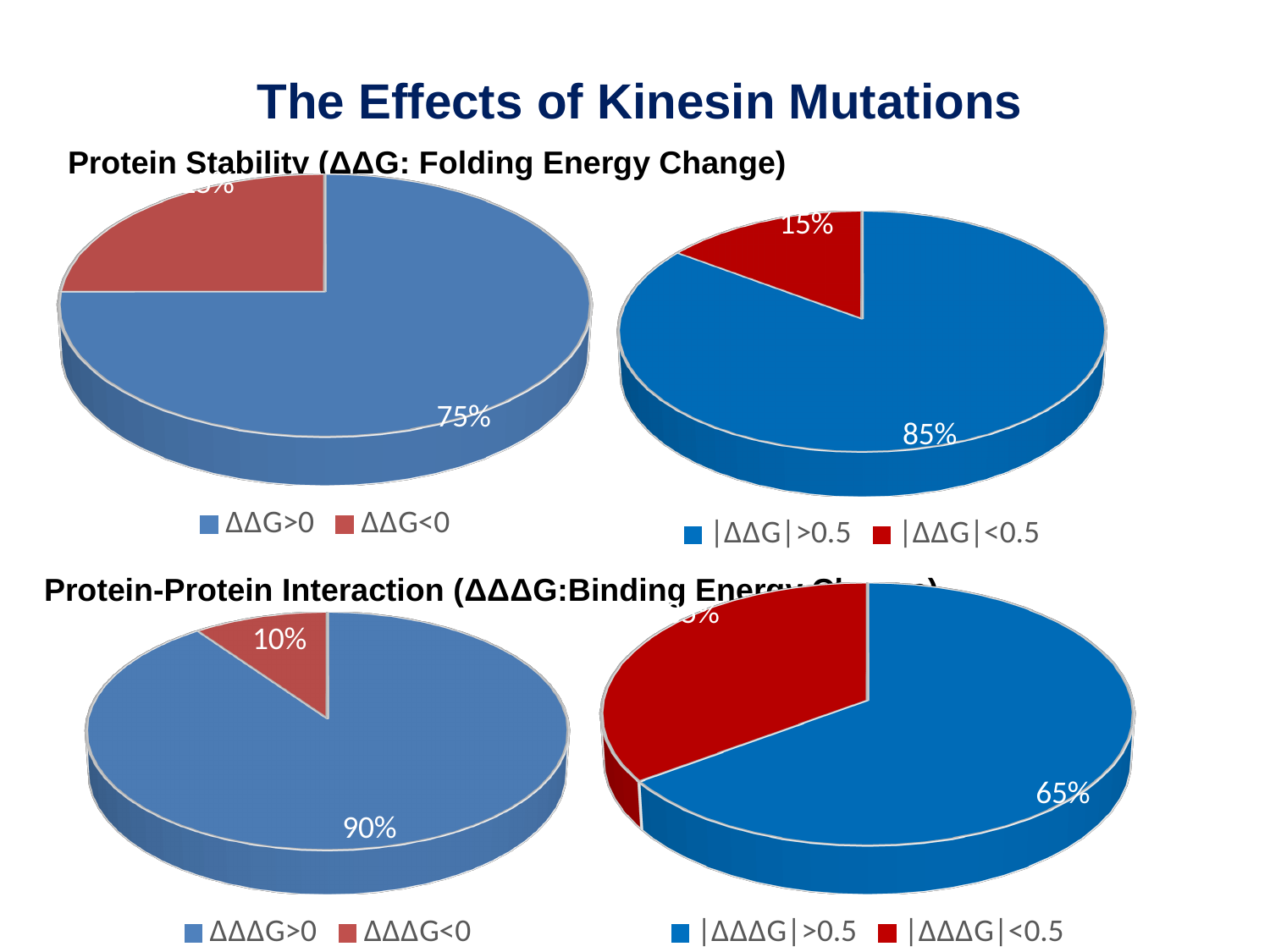
In the bottom-left pie chart, what percentage is shown for the ΔΔΔG>0 slice? 90% What type of chart is used in the bottom-right chart? Pie chart In the bottom-right pie chart, what percentage is shown for the |ΔΔΔG|>0.5 slice? 65% In the bottom-left pie chart, which slice is larger, ΔΔΔG>0 or ΔΔΔG<0? ΔΔΔG>0 How many entries does the legend of the top-right pie chart list? 2 In the top-right pie chart, what is the difference in percentage points between the |ΔΔG|>0.5 slice and the |ΔΔG|<0.5 slice? 70 In the top-right pie chart, what percentage is shown for the |ΔΔG|<0.5 slice? 15% In the top-right pie chart, what percentage is shown for the |ΔΔG|>0.5 slice? 85% In the top-left pie chart, which slice is the smallest? ΔΔG<0 In the bottom-right pie chart, which slice is the largest? |ΔΔΔG|>0.5 In the top-left pie chart, what percentage is shown for the ΔΔG>0 slice? 75% In the bottom-left pie chart, what percentage is shown for the ΔΔΔG<0 slice? 10%